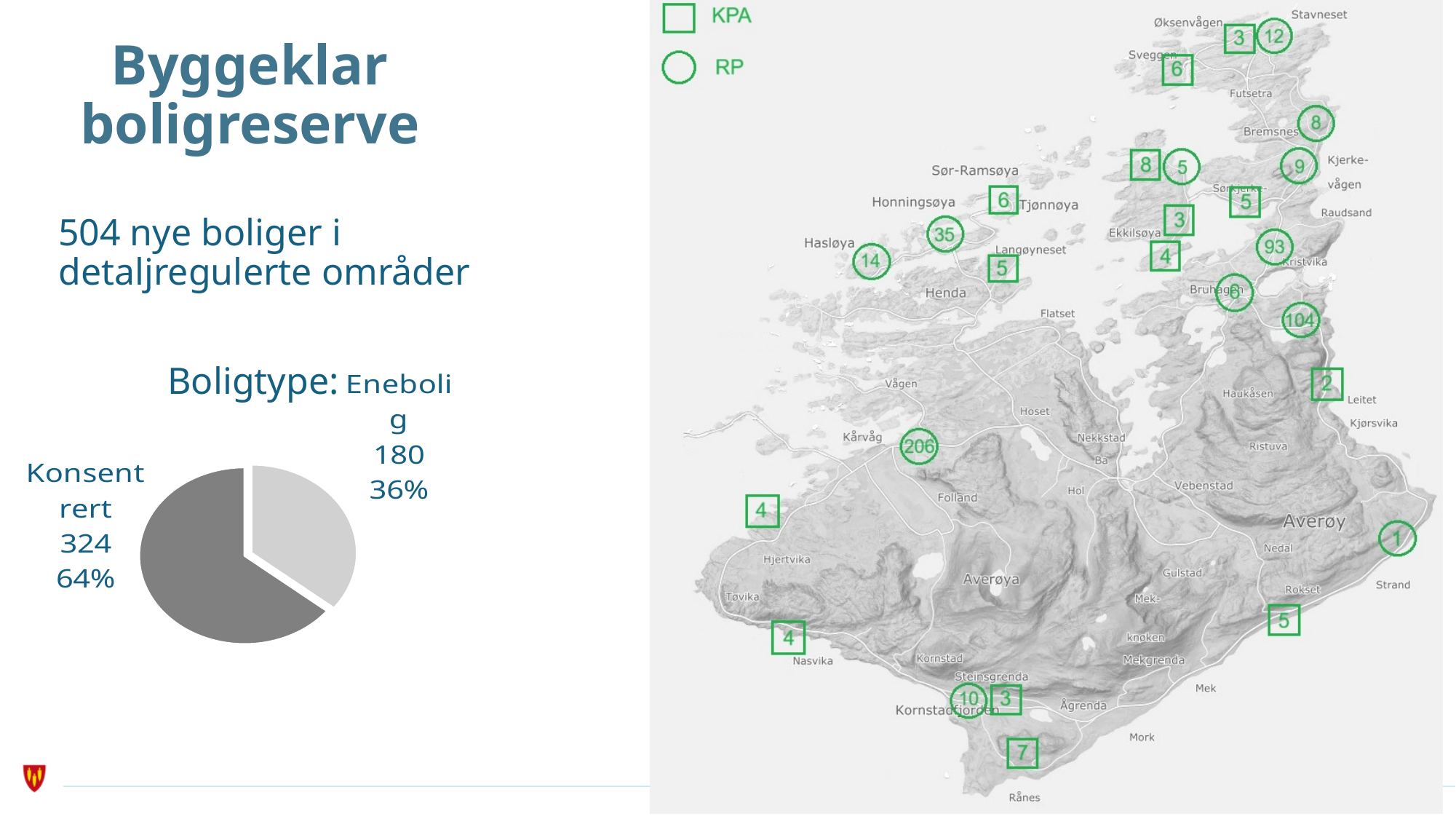
In the "Boligtype:" pie chart, what is the difference between the Konsentrert value and the Enebolig value? 144 In the "Boligtype:" pie chart, what share of the pie does Enebolig represent? 36% Which slice of the "Boligtype:" pie chart is the smallest? Enebolig In the "Boligtype:" pie chart, what is the value for Enebolig? 180 What kind of chart is shown under the heading "Boligtype:"? pie chart How many slices does the "Boligtype:" pie chart have? 2 In the "Boligtype:" pie chart, what share of the pie does Konsentrert represent? 64% In the "Boligtype:" pie chart, what is the value for Konsentrert? 324 In the "Boligtype:" pie chart, which is larger: Enebolig or Konsentrert? Konsentrert What is the title of the pie chart on the slide? Boligtype: What is the total of the two slices in the "Boligtype:" pie chart? 504 Which slice of the "Boligtype:" pie chart is the largest? Konsentrert